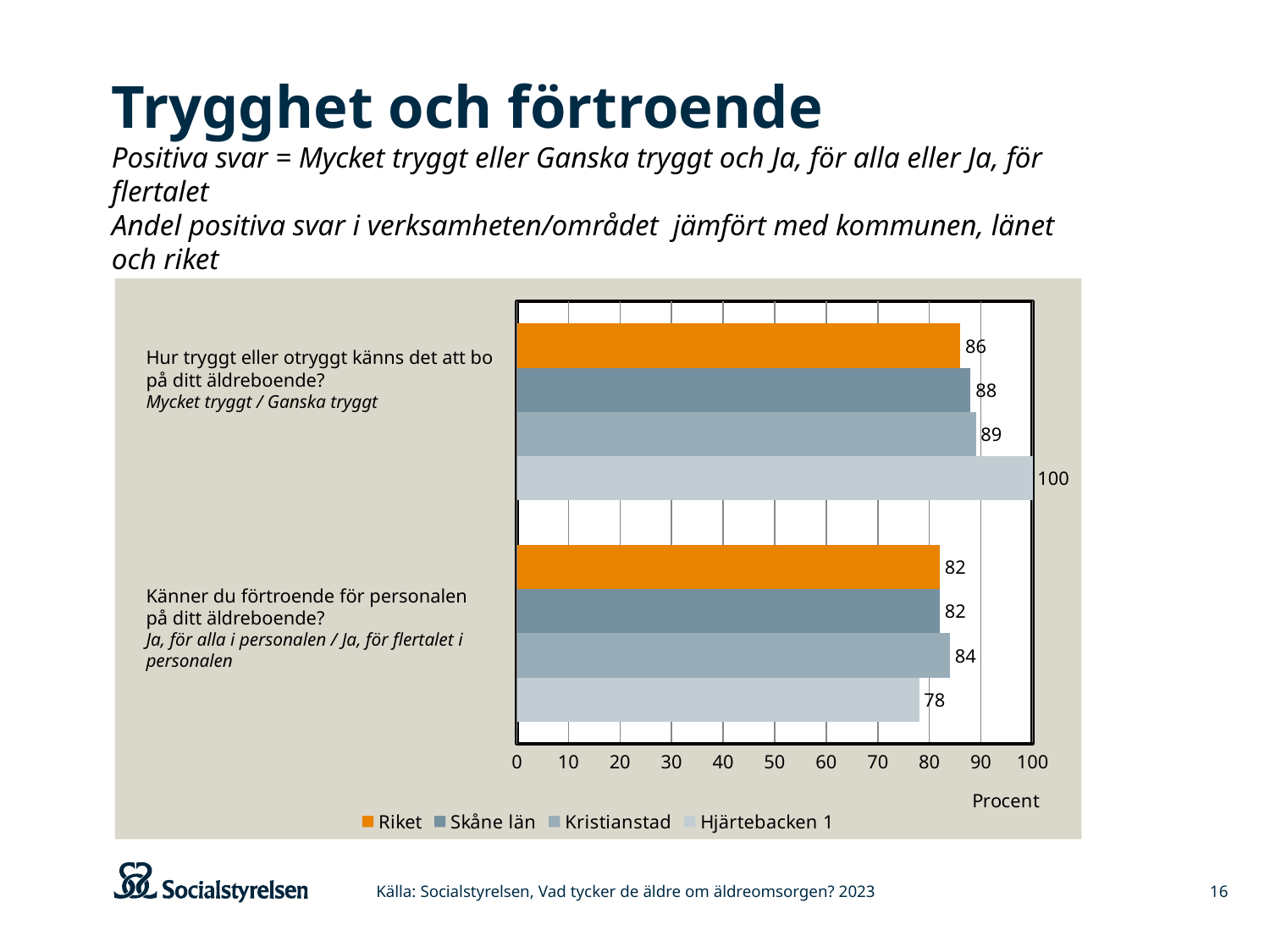
Which is larger on the question "Känner du förtroende för personalen på ditt äldreboende?": Kristianstad or Hjärtebacken 1? Kristianstad What is the value for Kristianstad on the question "Hur tryggt eller otryggt känns det att bo på ditt äldreboende?"? 89 What is the difference between Kristianstad and Hjärtebacken 1 on the question "Känner du förtroende för personalen på ditt äldreboende?"? 6 What is the value for Hjärtebacken 1 on the question "Hur tryggt eller otryggt känns det att bo på ditt äldreboende?"? 100 What is the value for Riket on the question "Känner du förtroende för personalen på ditt äldreboende?"? 82 What is the value for Hjärtebacken 1 on the question "Känner du förtroende för personalen på ditt äldreboende?"? 78 Which series has the highest value on the question "Hur tryggt eller otryggt känns det att bo på ditt äldreboende?"? Hjärtebacken 1 How many series does the legend list? 4 What kind of chart is shown on the slide? Bar chart What is the label on the horizontal axis of the chart? Procent Which series has the lowest value on the question "Känner du förtroende för personalen på ditt äldreboende?"? Hjärtebacken 1 What is the difference between Hjärtebacken 1 and Riket on the question "Hur tryggt eller otryggt känns det att bo på ditt äldreboende?"? 14